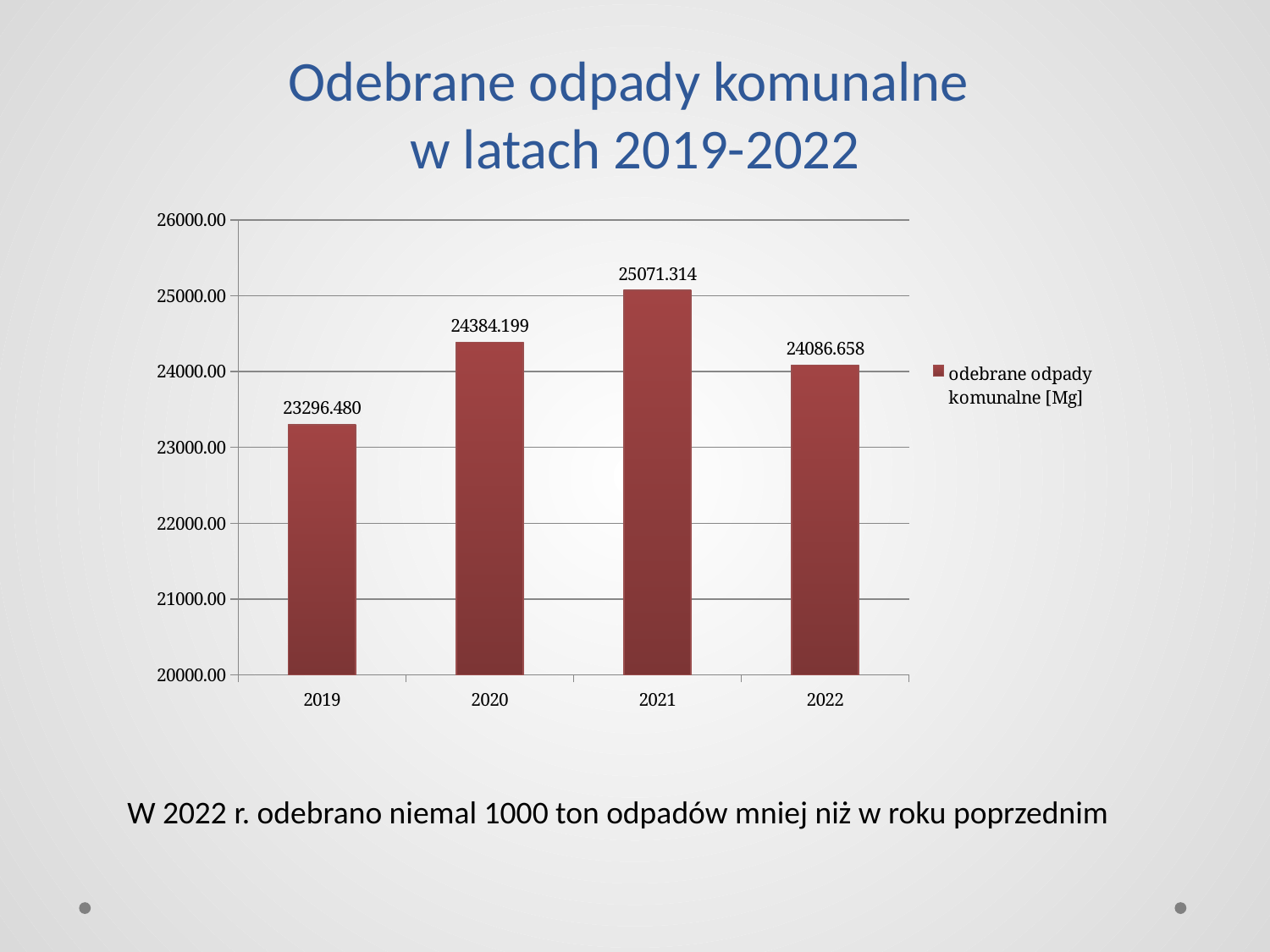
Which is larger, the value for 2020 or the value for 2022? 2020 How many years are shown on the x axis? 4 What is the value for 2021? 25071.314 How many series does the legend list? 1 Which year has the highest value? 2021 Is the value for 2019 greater or less than 24000.00? less What is the difference between the values for 2021 and 2022? 984.656 Which year has the lowest value? 2019 What is the value for 2019? 23296.480 What kind of chart is shown? bar chart What is the legend entry for the series? odebrane odpady komunalne [Mg] What is the value for 2022? 24086.658